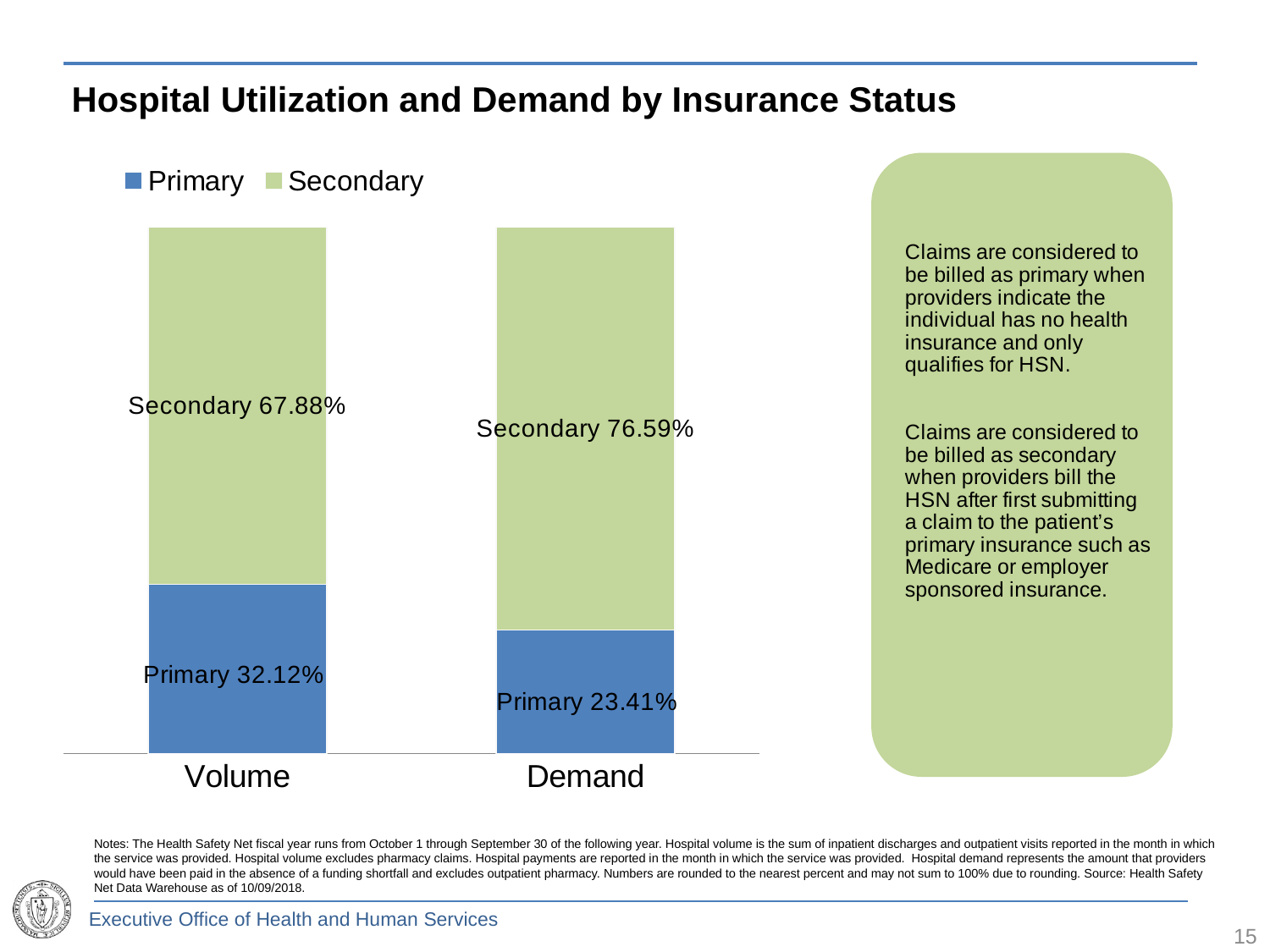
Which category has the higher Primary share, Volume or Demand? Volume What is the difference between the Primary shares for Volume and Demand? 8.71% What is the Primary share for Demand? 23.41% Which category has the highest Secondary share? Demand How many categories are shown on the x axis? 2 What is the total of the Volume stacked bar? 100% What is the Secondary share for Demand? 76.59% How many series does the legend list? 2 What is the Secondary share for Volume? 67.88% What is the Primary share for Volume? 32.12% What is the difference between the Secondary shares for Demand and Volume? 8.71% What kind of chart is shown on the slide? Stacked bar chart